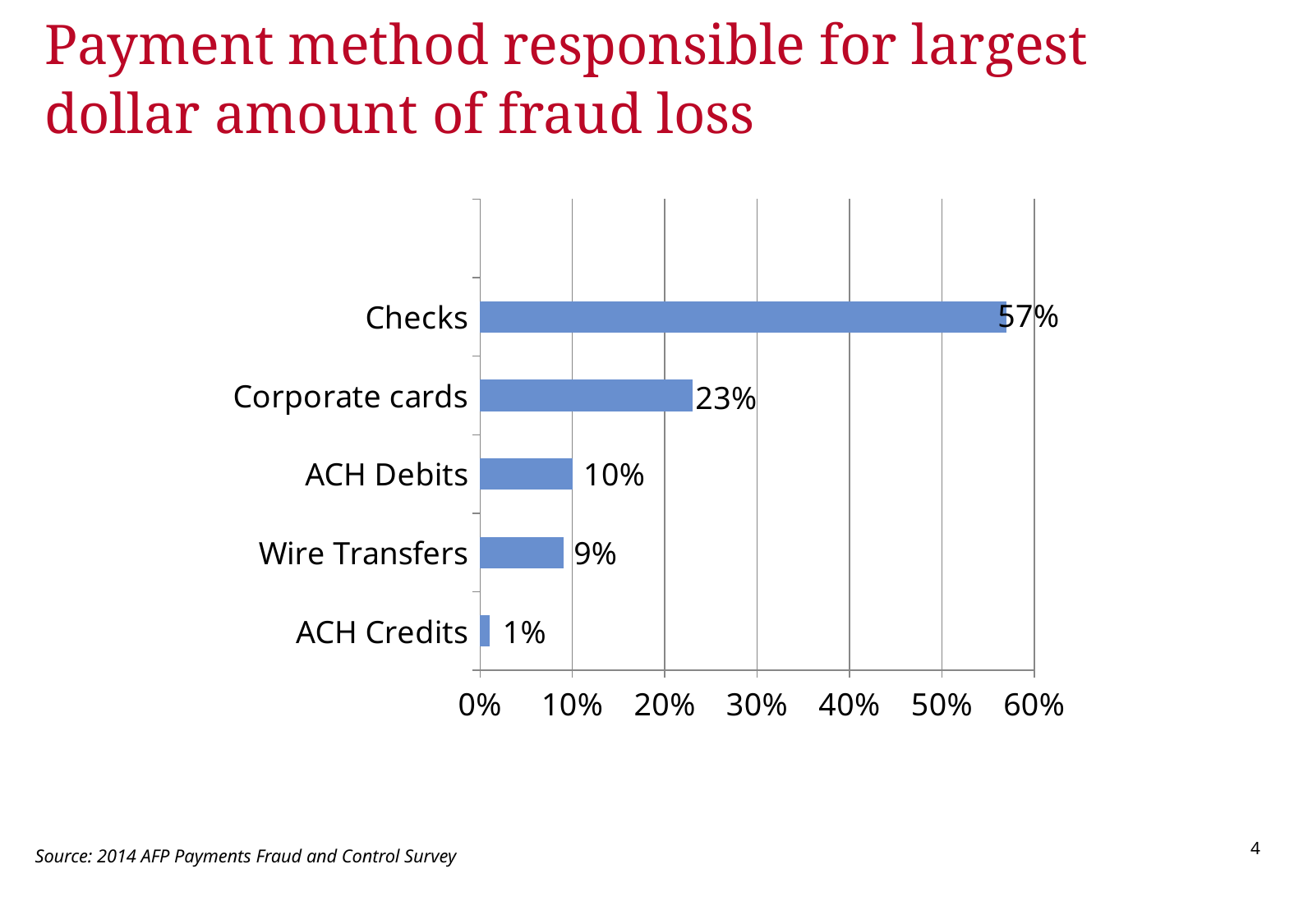
What kind of chart is shown on the slide? Bar chart What percentage is shown for Wire Transfers? 9% What percentage is shown for Corporate cards? 23% What percentage is shown for ACH Credits? 1% What is the difference between the values for Checks and Corporate cards? 34% Which is larger, the value for Corporate cards or the value for ACH Debits? Corporate cards What percentage is shown for Checks? 57% What percentage is shown for ACH Debits? 10% Which payment method has the lowest value? ACH Credits What is the title of the slide? Payment method responsible for largest dollar amount of fraud loss Which payment method has the highest value? Checks How many payment methods are shown in the chart? 5